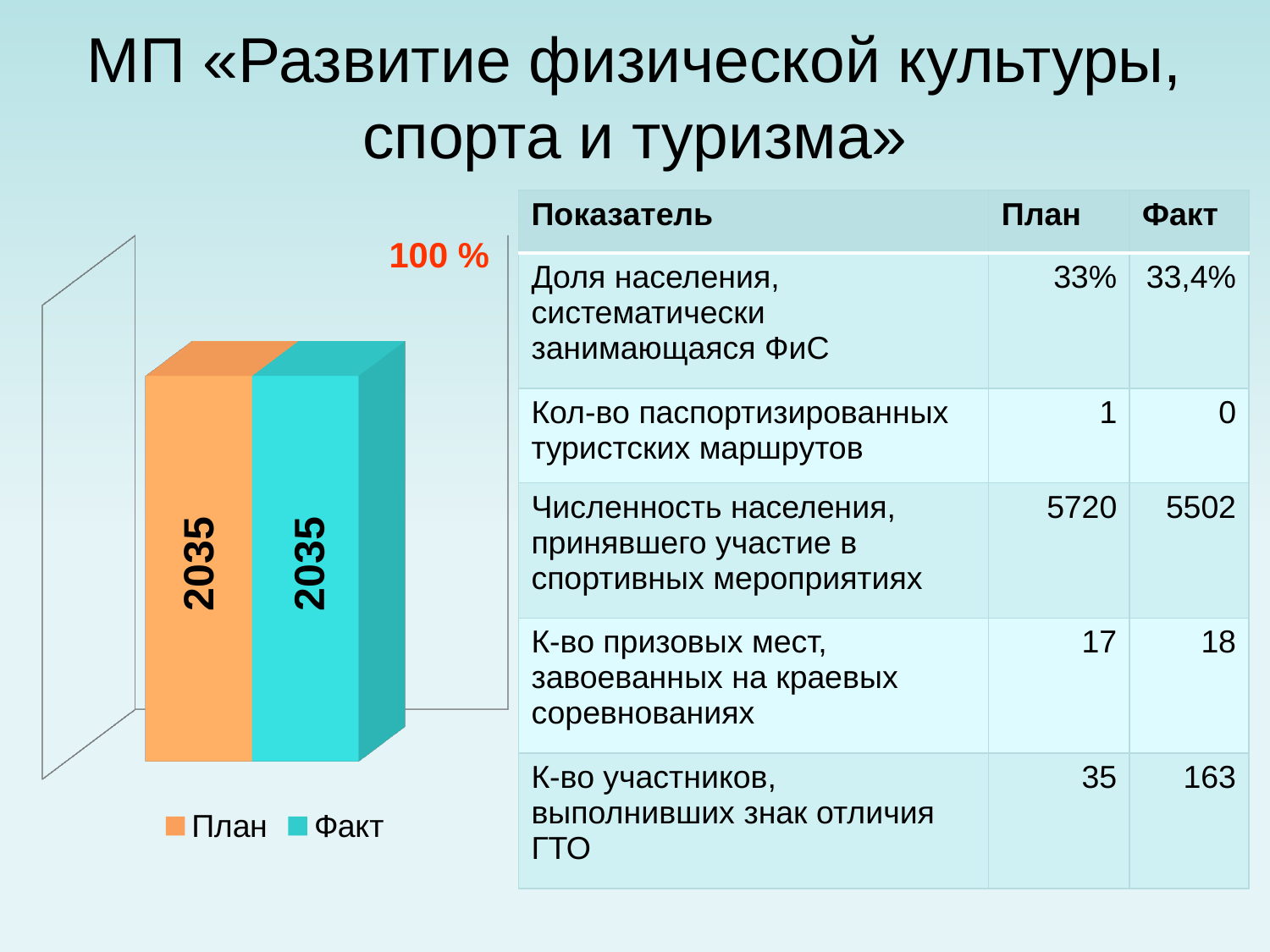
What is the difference between the План and Факт values shown on the bars? 0 How many bars are plotted in the chart? 2 What value is printed on the План bar in the chart? 2035 Which series in the chart legend is shown in orange? План How many series does the chart legend list? 2 What percentage label is printed above the chart? 100 % What kind of chart is shown on the left of the slide? bar chart What value is printed on the Факт bar in the chart? 2035